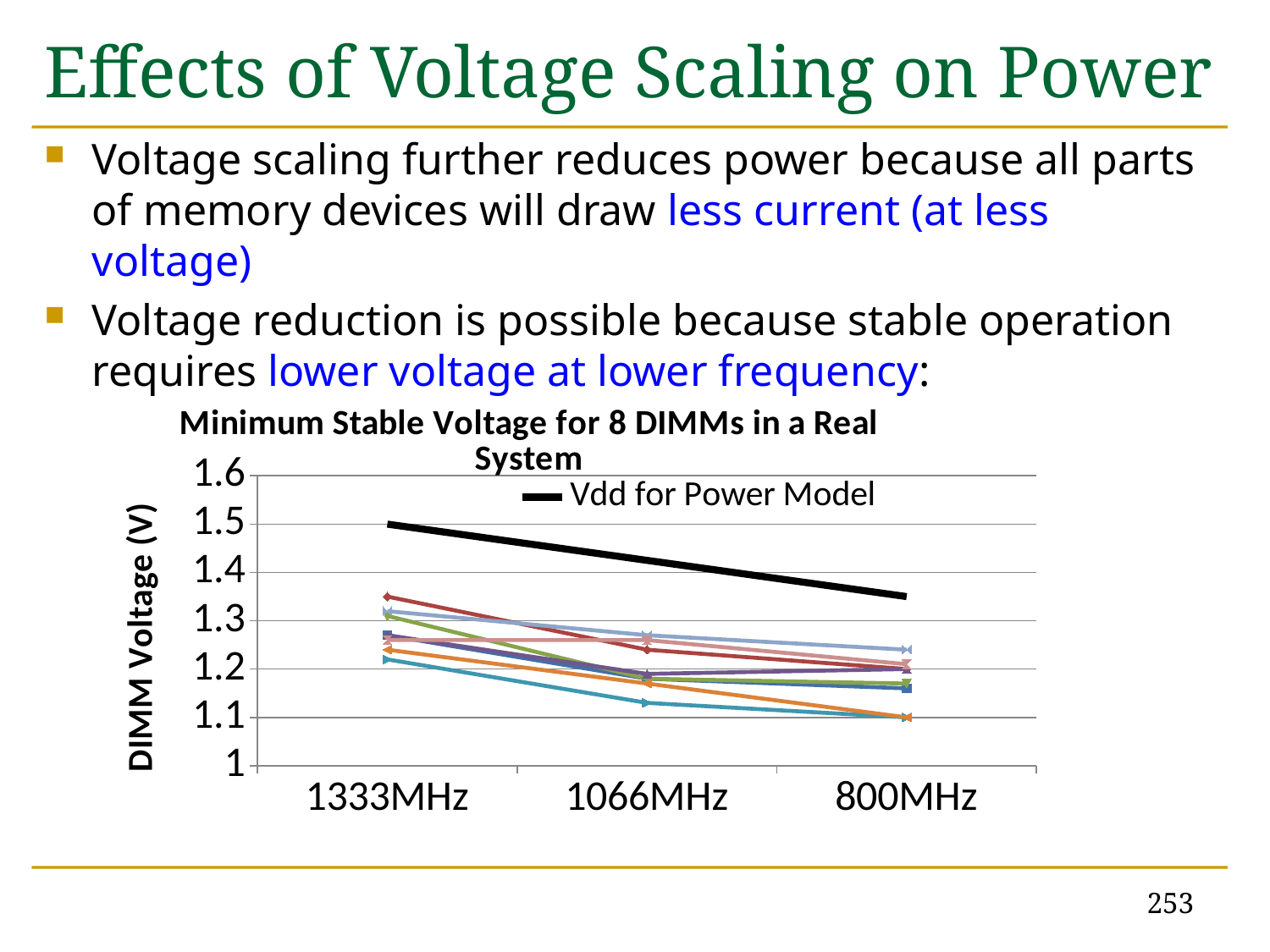
What is the label of the chart's y axis? DIMM Voltage (V) What is the value of the Vdd for Power Model line at 1333MHz? 1.5 What kind of chart is shown on the slide? line chart Is the Vdd for Power Model value at 1066MHz greater or less than 1.4? greater Does the Vdd for Power Model line rise or fall from 1333MHz to 800MHz? fall How many frequency categories are shown on the x axis of the chart? 3 Which is larger for the Vdd for Power Model line: the value at 1333MHz or the value at 800MHz? 1333MHz At which frequency is the Vdd for Power Model line highest? 1333MHz How many series does the chart's legend list? 1 Is the Vdd for Power Model value at 1333MHz greater or less than 1.4? greater Is the Vdd for Power Model value at 800MHz greater or less than 1.4? less What is the title of the chart? Minimum Stable Voltage for 8 DIMMs in a Real System